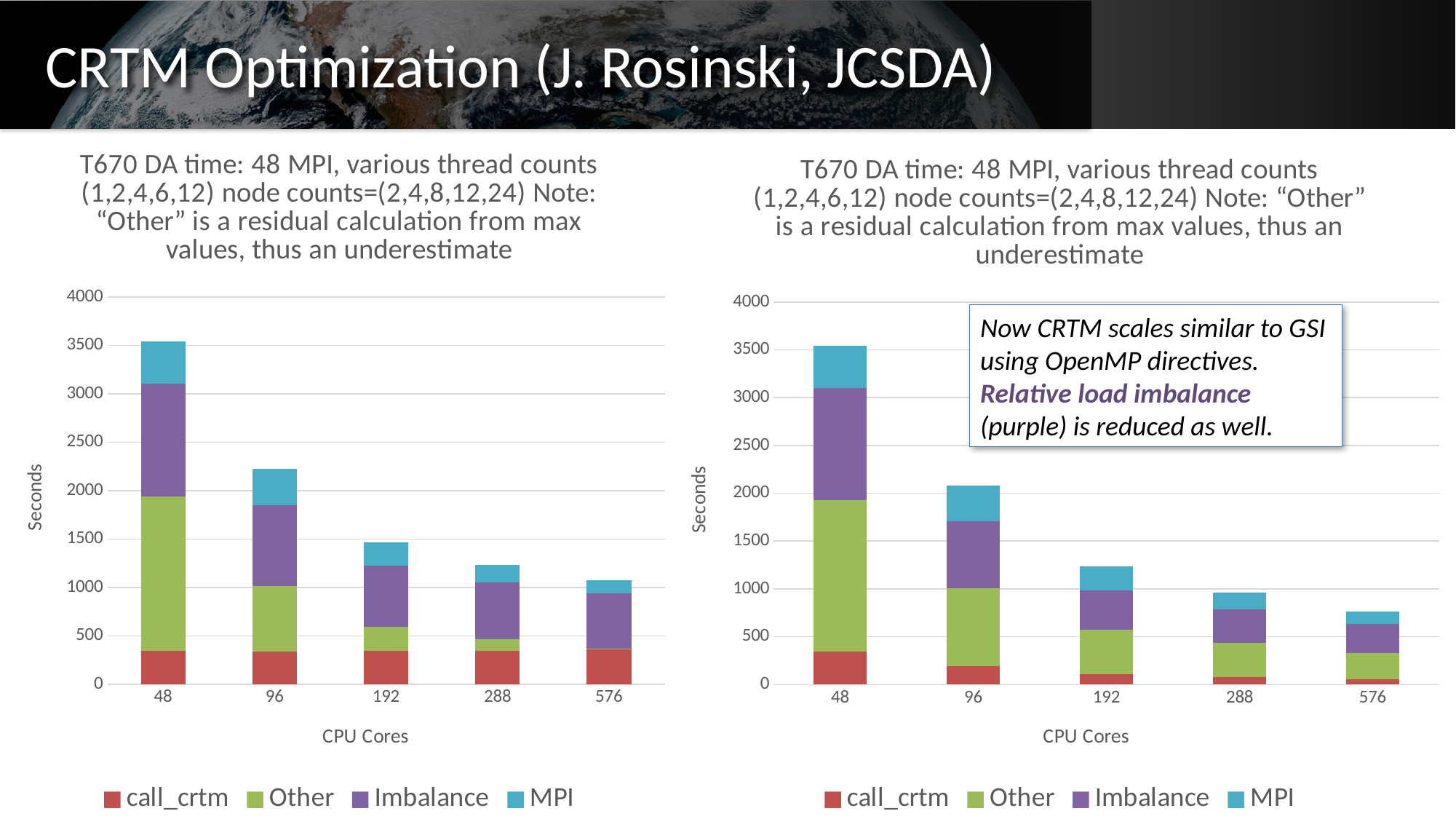
In the left chart, which CPU core count has the tallest total bar? 48 Which chart has the larger total bar at 576 CPU cores, the left chart or the right chart? left chart What are the legend entries of the right chart? call_crtm, Other, Imbalance, MPI How many CPU core categories are shown on the x axis of the right chart? 5 What is the x-axis label of the left chart? CPU Cores In the right chart, do the total times rise or fall as CPU cores increase along the x axis? fall What type of chart is the left chart? stacked bar chart In the left chart, is the total bar for 96 CPU cores greater or less than 2000 seconds? greater In the right chart, is the total bar for 576 CPU cores greater or less than 1000 seconds? less In the right chart, is the total bar for 48 CPU cores greater or less than 3000 seconds? greater How many series does the legend of the left chart list? 4 In the right chart, which CPU core count has the shortest total bar? 576